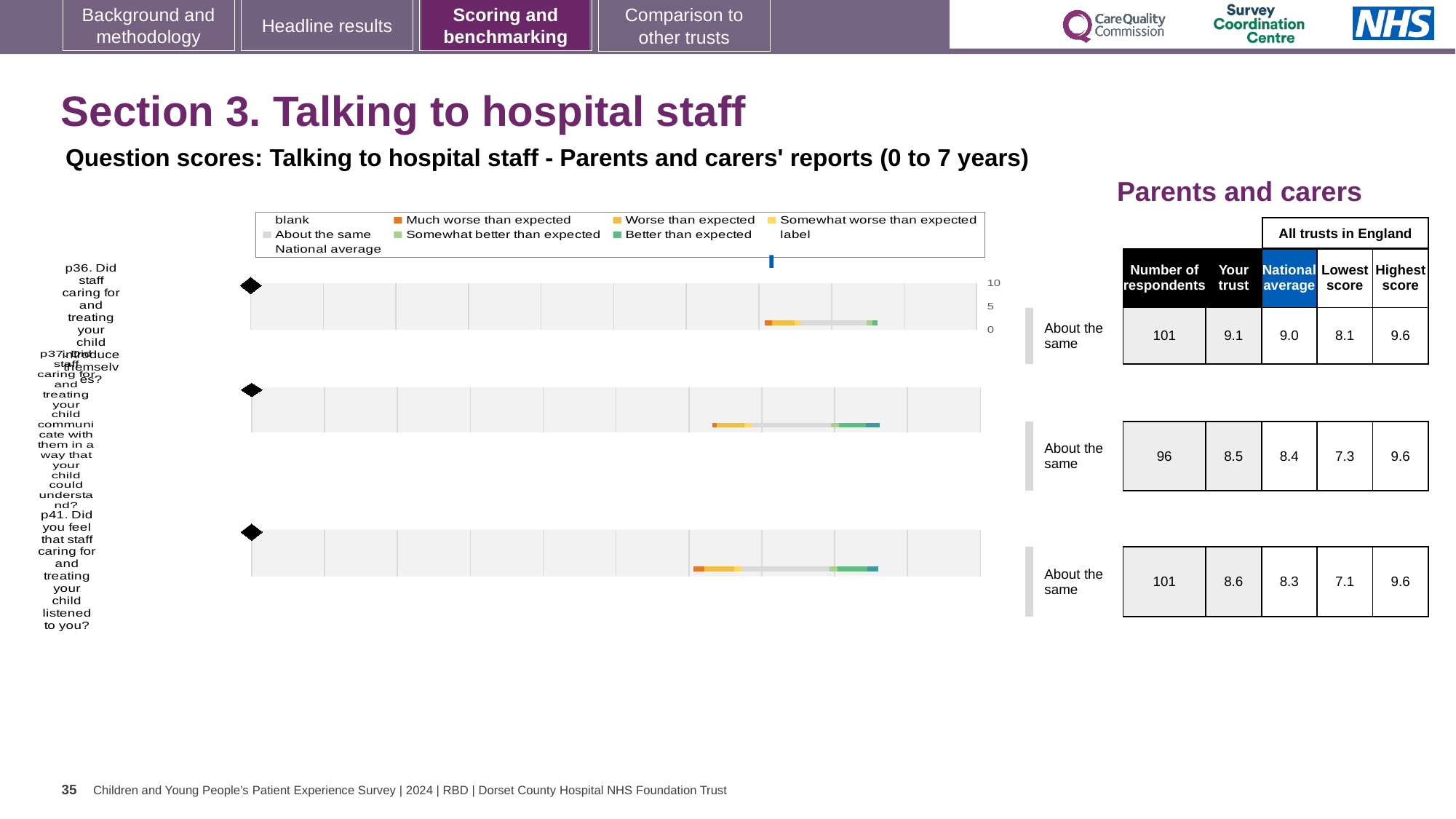
What is the difference between the trust score and the national average for p41? 0.3 Which question has the highest 'Your trust' score? p36 What is the lowest score among all trusts in England for p41 (Did you feel that staff listened to you?)? 7.1 What colour represents 'Much worse than expected' in the legend? orange How many respondents answered p37? 96 What kind of chart is shown on the slide? bar chart What is the national average score for p37 (Did staff communicate with your child in a way they could understand?)? 8.4 Which question has the lowest 'Your trust' score? p37 How many survey questions (rows) are plotted in the chart? 3 What is the 'Your trust' score for p36 (Did staff caring for and treating your child introduce themselves?)? 9.1 What benchmark category is shown for p36? About the same Which is larger, the trust score for p36 or the trust score for p41? p36